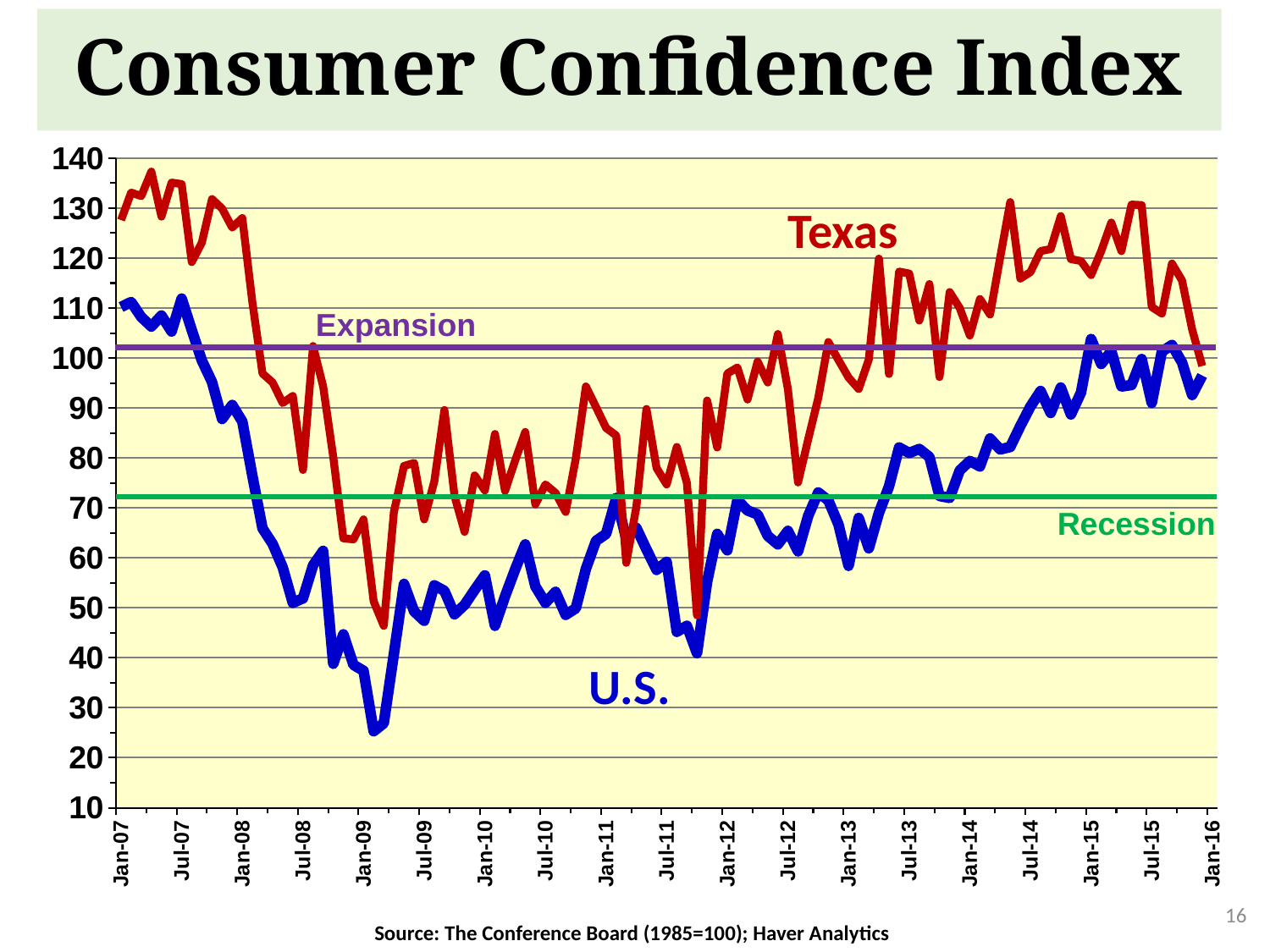
Is the lowest value of the U.S. series greater or less than 30? less Is the value for U.S. at Jan-07 greater or less than 100? greater What kind of chart is shown on the slide? line chart Is the value for Texas at Jan-07 greater or less than 120? greater Which two regions' series are plotted on the chart? Texas and U.S. At Jan-07, which series has the higher value, Texas or U.S.? Texas In which year does the U.S. series reach its lowest value? 2009 Which series is plotted in red? Texas What is the title of the chart? Consumer Confidence Index Does the U.S. series rise or fall between Jan-07 and Jan-09? fall Does the U.S. series rise or fall between Jan-12 and Jan-15? rise